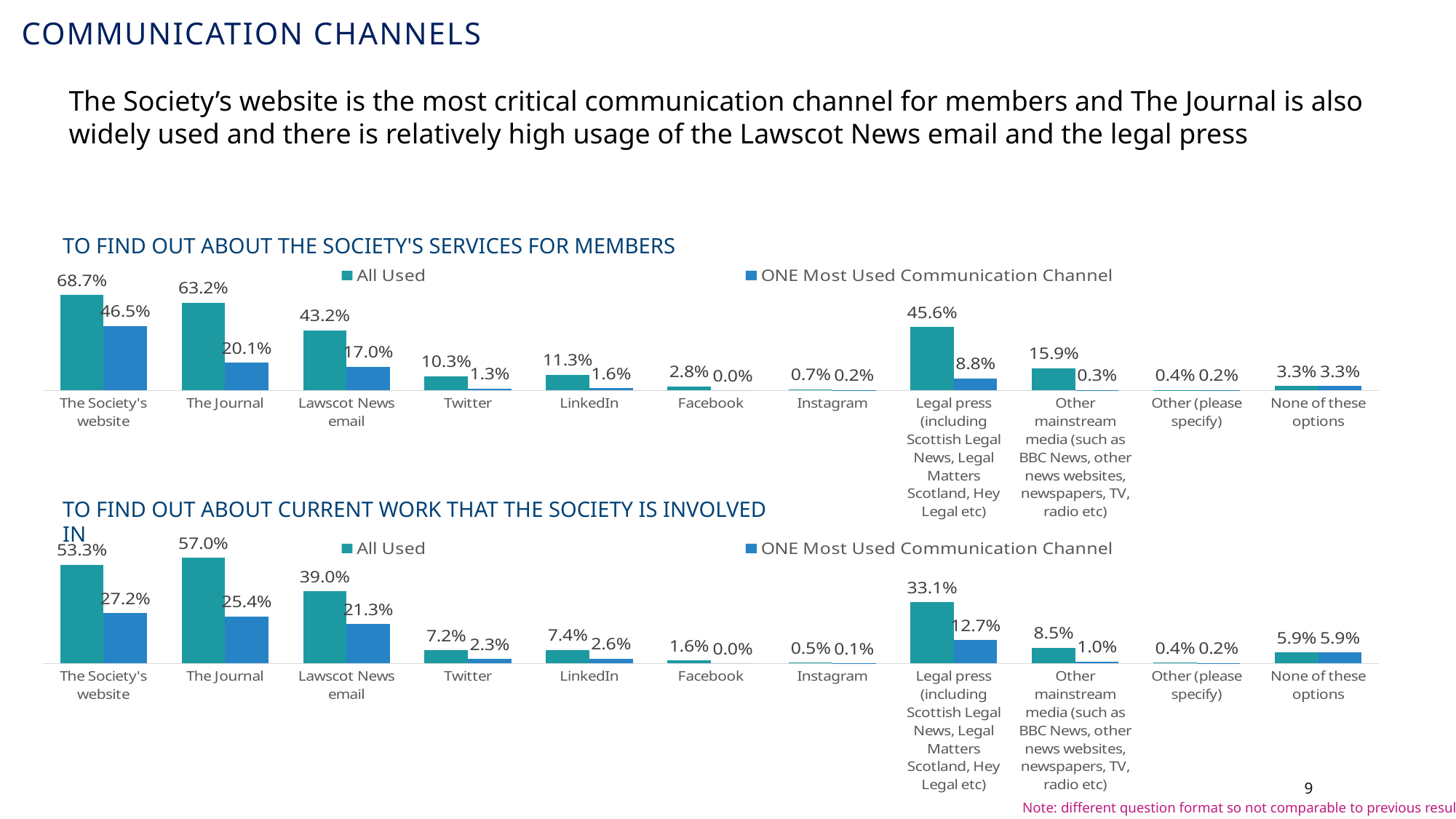
In the chart 'To find out about the Society's services for members', which category has the highest 'All Used' value? The Society's website How many categories are shown on the x axis of the chart 'To find out about current work that the Society is involved in'? 11 In the chart 'To find out about current work that the Society is involved in', what is the 'All Used' value for The Journal? 57.0% How many series does the legend list in the chart 'To find out about the Society's services for members'? 2 In the chart 'To find out about the Society's services for members', what is the 'All Used' value for The Society's website? 68.7% What type of chart is 'To find out about the Society's services for members'? Bar chart In the chart 'To find out about the Society's services for members', what is the 'ONE Most Used Communication Channel' value for The Journal? 20.1% In the chart 'To find out about current work that the Society is involved in', which is larger: the 'All Used' value for Twitter or for LinkedIn? LinkedIn In the chart 'To find out about current work that the Society is involved in', which category has the highest 'All Used' value? The Journal In the chart 'To find out about the Society's services for members', which category has the lowest 'All Used' value? Other (please specify) In the chart 'To find out about current work that the Society is involved in', what is the 'ONE Most Used Communication Channel' value for Lawscot News email? 21.3% In the chart 'To find out about the Society's services for members', what is the difference between the 'All Used' values for The Society's website and The Journal? 5.5%